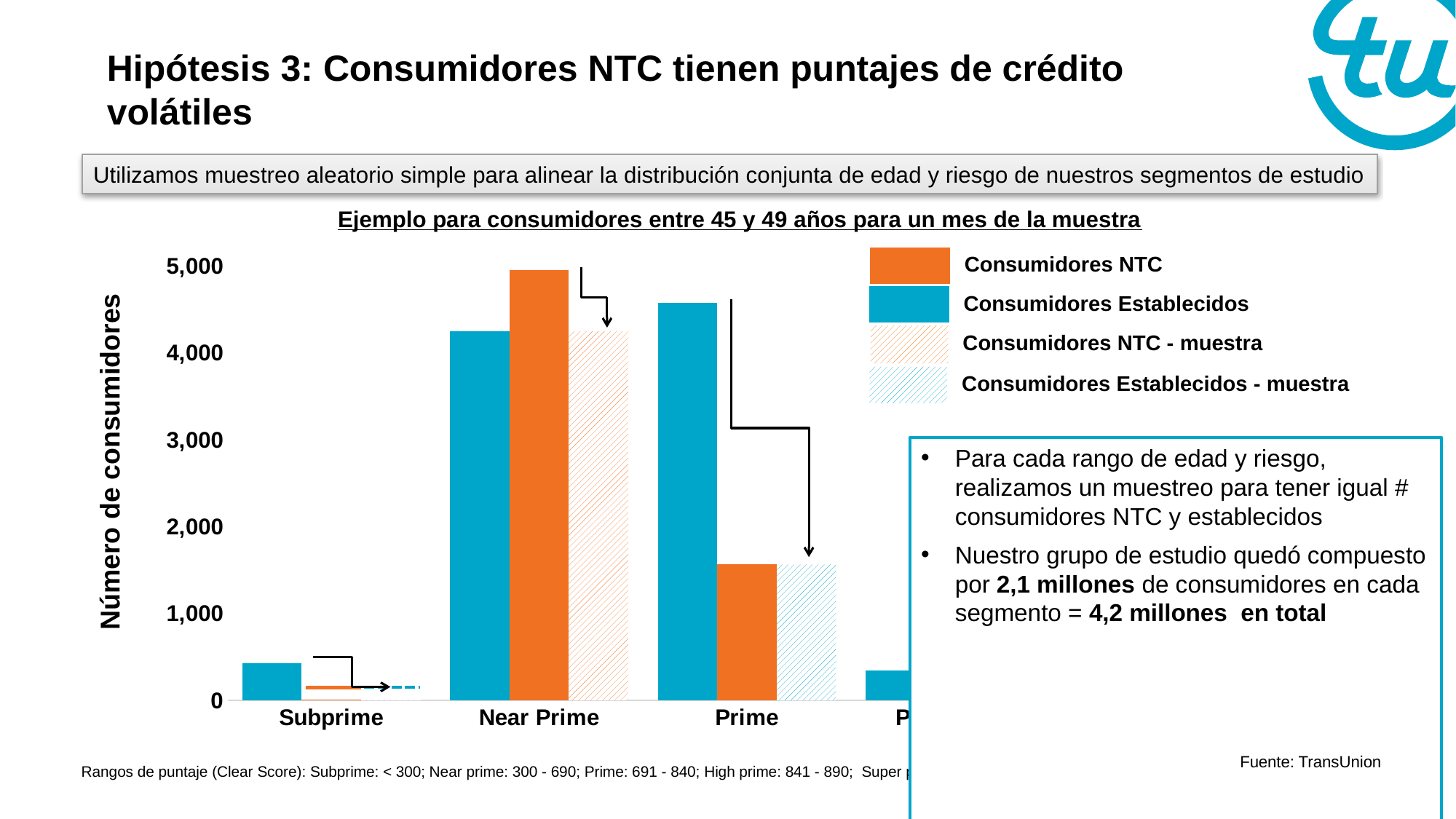
In the Near Prime category, which is larger: Consumidores NTC or Consumidores Establecidos? Consumidores NTC In the Prime category, which is larger: Consumidores Establecidos or Consumidores NTC? Consumidores Establecidos Is the value for Consumidores Establecidos in the Subprime category greater or less than 1,000? less In which category is the Consumidores NTC bar the highest? Near Prime Is the value for Consumidores NTC in the Near Prime category greater or less than 4,000? greater Which series is shown in solid orange in the chart legend? Consumidores NTC Is the value for Consumidores NTC in the Prime category greater or less than 2,000? less What kind of chart is shown on the slide? bar chart What is the label of the y axis of the chart? Número de consumidores How many series does the chart legend list? 4 Among Subprime, Near Prime and Prime, in which category is the Consumidores Establecidos bar the lowest? Subprime